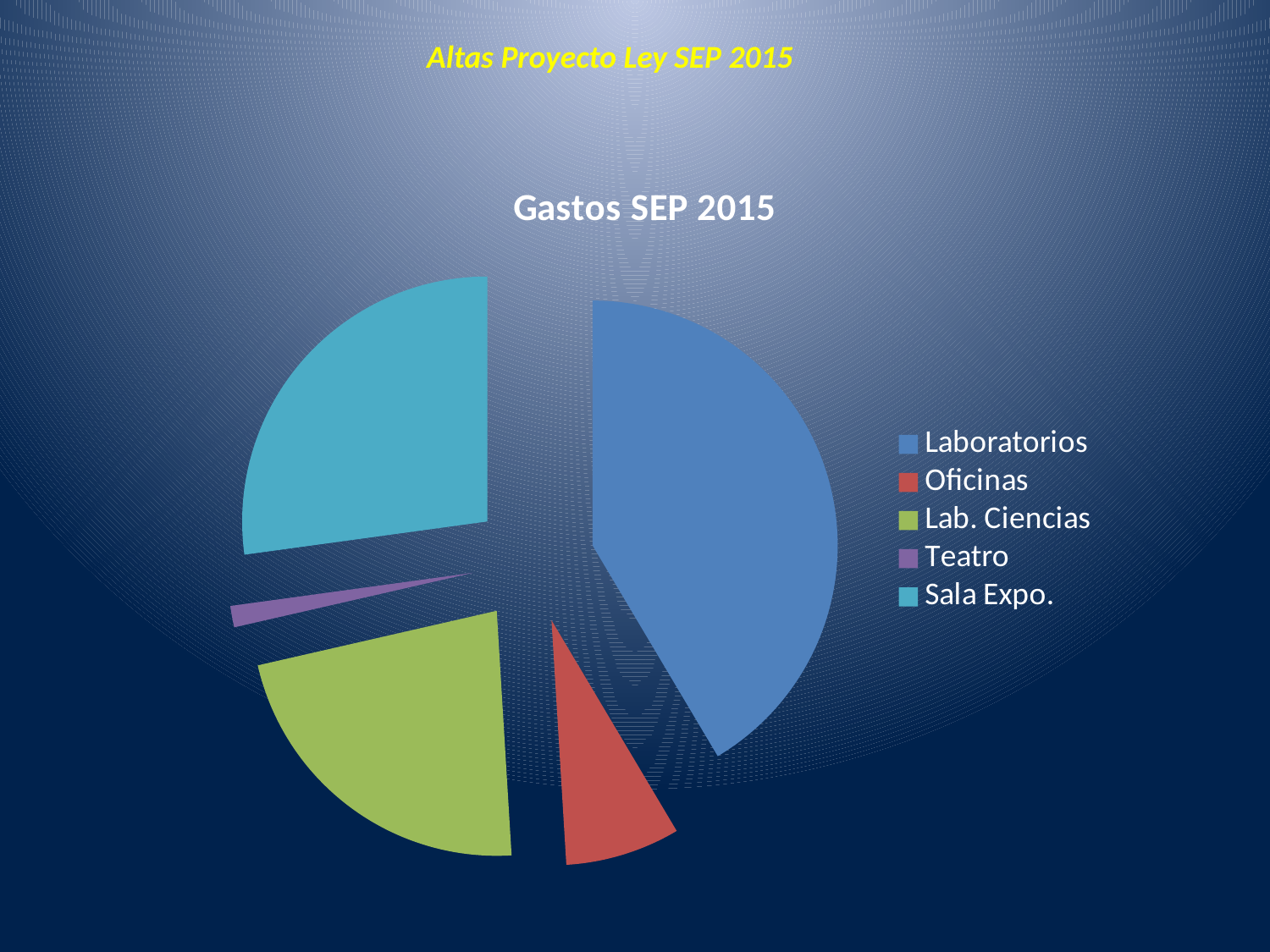
Which slice is larger, Sala Expo. or Oficinas? Sala Expo. How many entries does the legend list? 5 Which category has the smallest slice of the pie? Teatro Which category has the largest slice of the pie? Laboratorios Which slice is larger, Teatro or Oficinas? Oficinas Which slice is larger, Laboratorios or Sala Expo.? Laboratorios Which category is shown in red in the pie chart? Oficinas How many categories does the pie chart have? 5 What kind of chart is shown on the slide? pie chart What is the title of the chart? Gastos SEP 2015